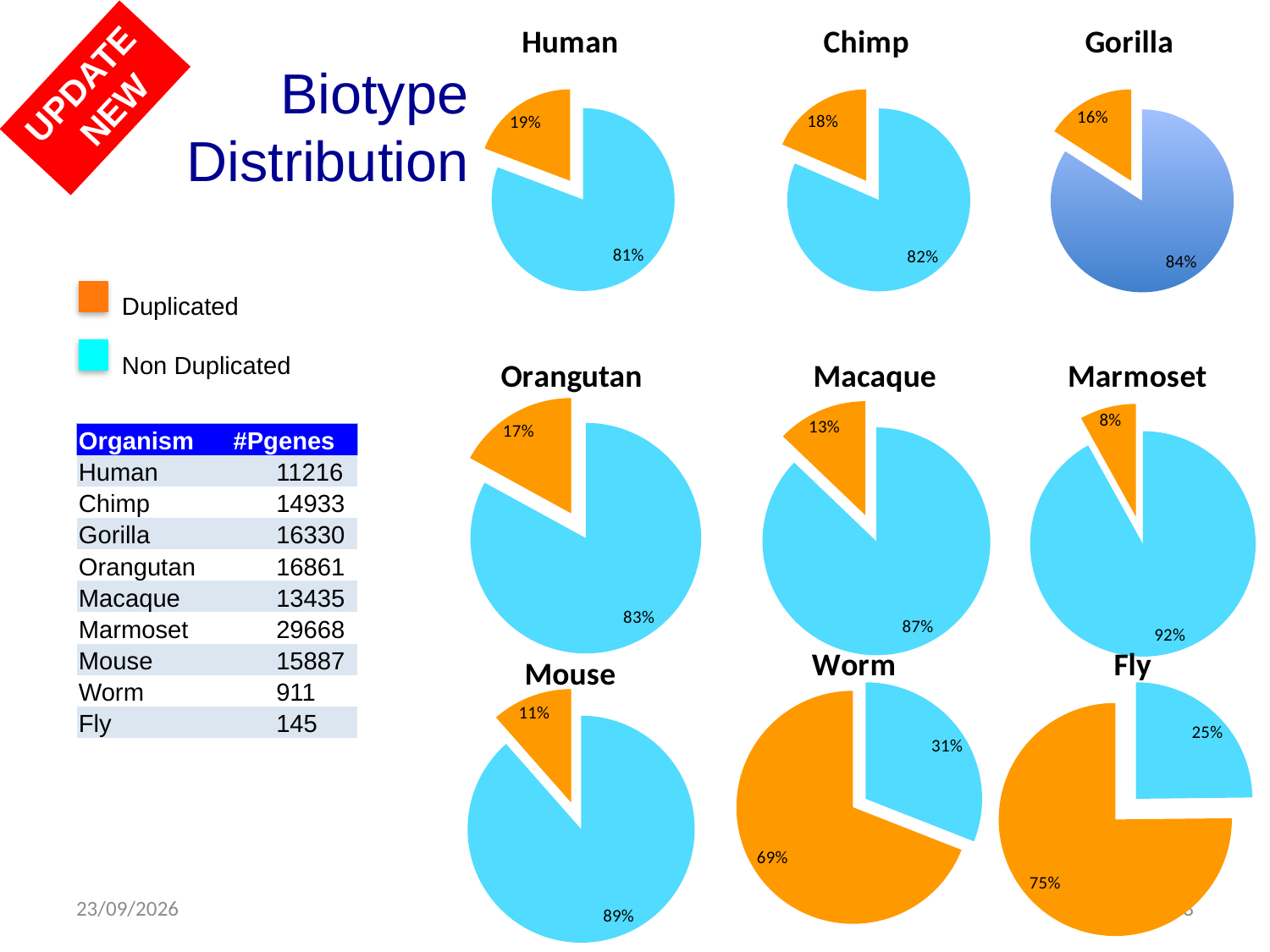
In the Mouse pie chart, which slice is larger, Duplicated or Non Duplicated? Non Duplicated How many categories does the legend on the slide list? 2 In the Human pie chart, what share is Duplicated? 19% In the Macaque pie chart, what is the difference between the Non Duplicated and Duplicated shares? 74% In the Worm pie chart, which slice is larger, Duplicated or Non Duplicated? Duplicated In the Marmoset pie chart, what share is Duplicated? 8% In the Fly pie chart, what percentage is shown for the Duplicated slice? 75% How many pie charts are shown on the slide? 9 What kind of chart is used for the Orangutan biotype distribution? Pie chart In the Chimp pie chart, what share is Non Duplicated? 82% In the Gorilla pie chart, what percentage is shown for the Duplicated slice? 16%